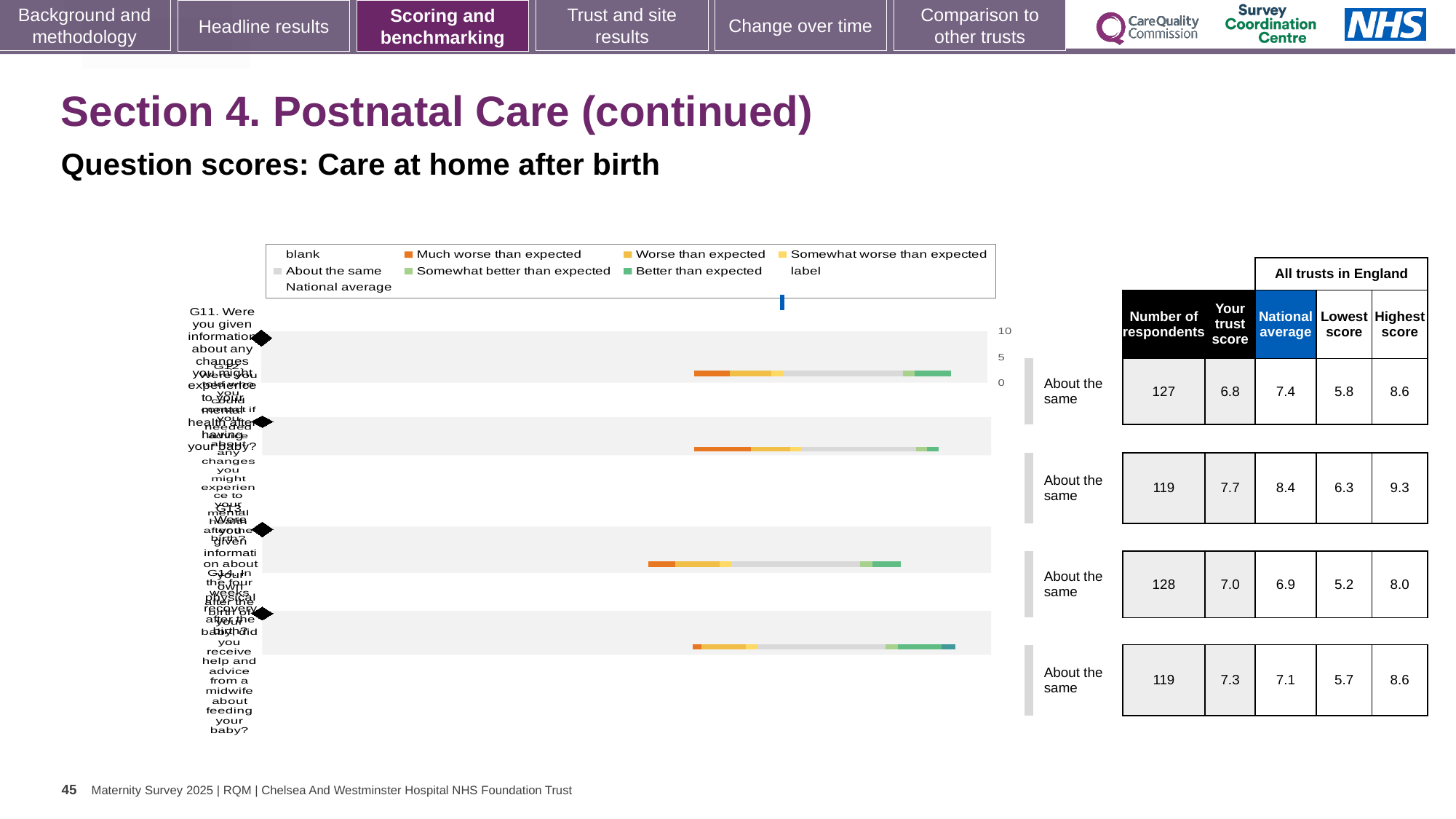
How many respondents are listed for question G11 (the first row)? 127 For the third row, is the trust score (7.0) or the national average (6.9) larger? the trust score (7.0) What is the 'Your trust score' for question G11 (the first row)? 6.8 Which legend entry is shown in orange? Much worse than expected How many question rows (bars) are plotted in the chart? 4 What is the lowest score among all trusts in England for the second row? 6.3 What kind of chart is shown on the slide? bar chart What is the national average for question G11 (the first row)? 7.4 What is the difference between the national average and the trust score for question G11 (the first row)? 0.6 Which row has the highest 'Your trust score'? the second row (7.7) What is the highest score among all trusts in England for question G11 (the first row)? 8.6 What benchmark rating is shown for each of the four questions? About the same